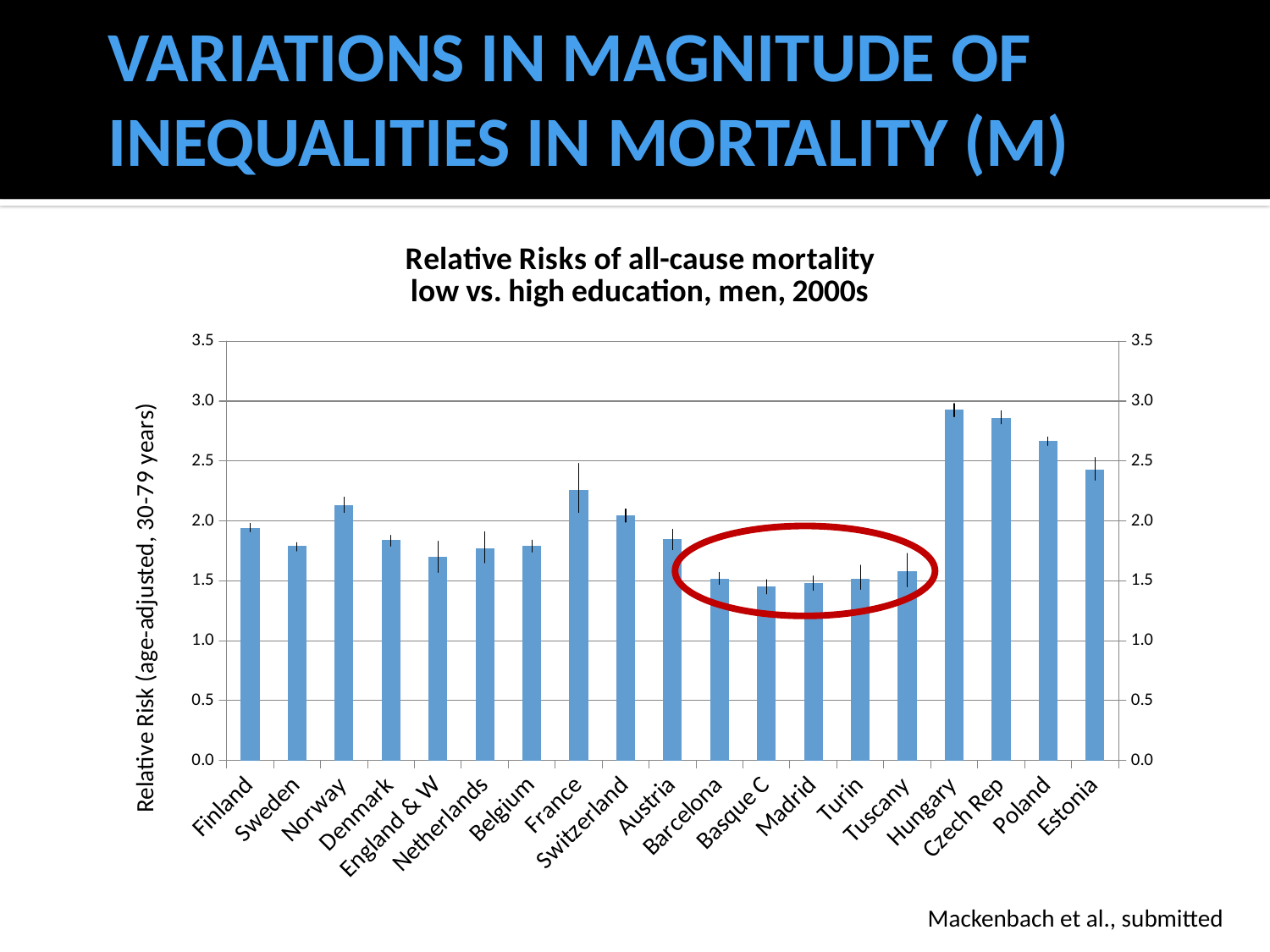
Which has the larger relative risk, Poland or Estonia? Poland Is the value for France greater or less than 2.0? greater Is the value for Finland greater or less than 2.0? less What is the title of the chart? Relative Risks of all-cause mortality low vs. high education, men, 2000s How many countries or regions are shown on the x axis of the chart? 19 Is the value for Hungary greater or less than 2.5? greater What kind of chart is shown on the slide? Bar chart Which country or region has the highest relative risk in the chart? Hungary Which has the larger relative risk, France or Switzerland? France What is the label of the y axis of the chart? Relative Risk (age-adjusted, 30-79 years)